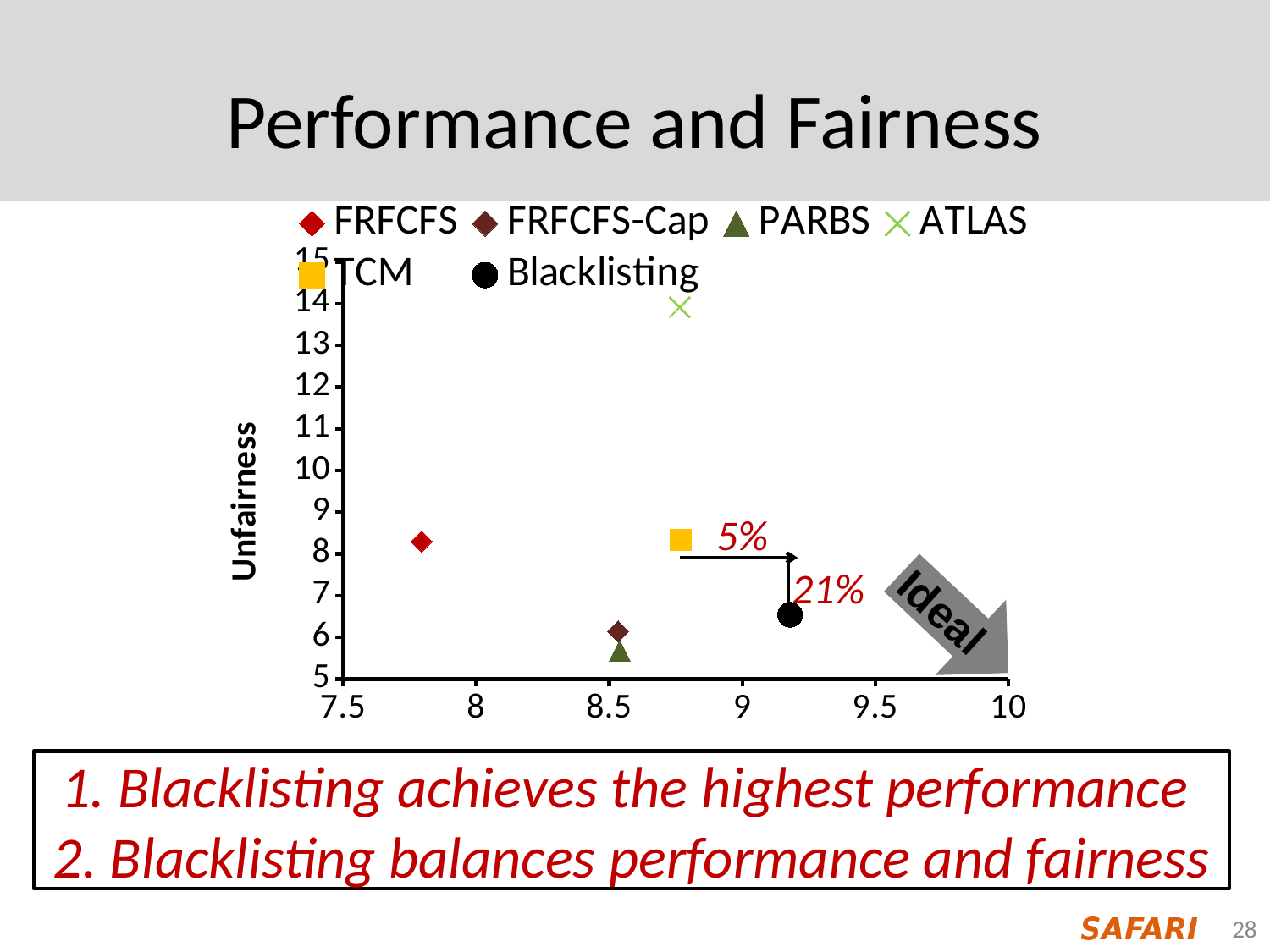
What is the label of the y axis? Unfairness Is the Unfairness value for Blacklisting greater or less than 7? less What kind of chart is shown on the slide? scatter chart Which series is plotted furthest to the left on the x axis? FRFCFS Is the x-axis value for Blacklisting greater or less than 9? greater Which series has the highest Unfairness value? ATLAS How many series does the legend list? 6 Which series is plotted furthest to the right on the x axis? Blacklisting Which series has the lowest Unfairness value? PARBS Which has the higher Unfairness value, ATLAS or TCM? ATLAS How many data points are plotted on the chart? 6 Is the Unfairness value for ATLAS greater or less than 13? greater